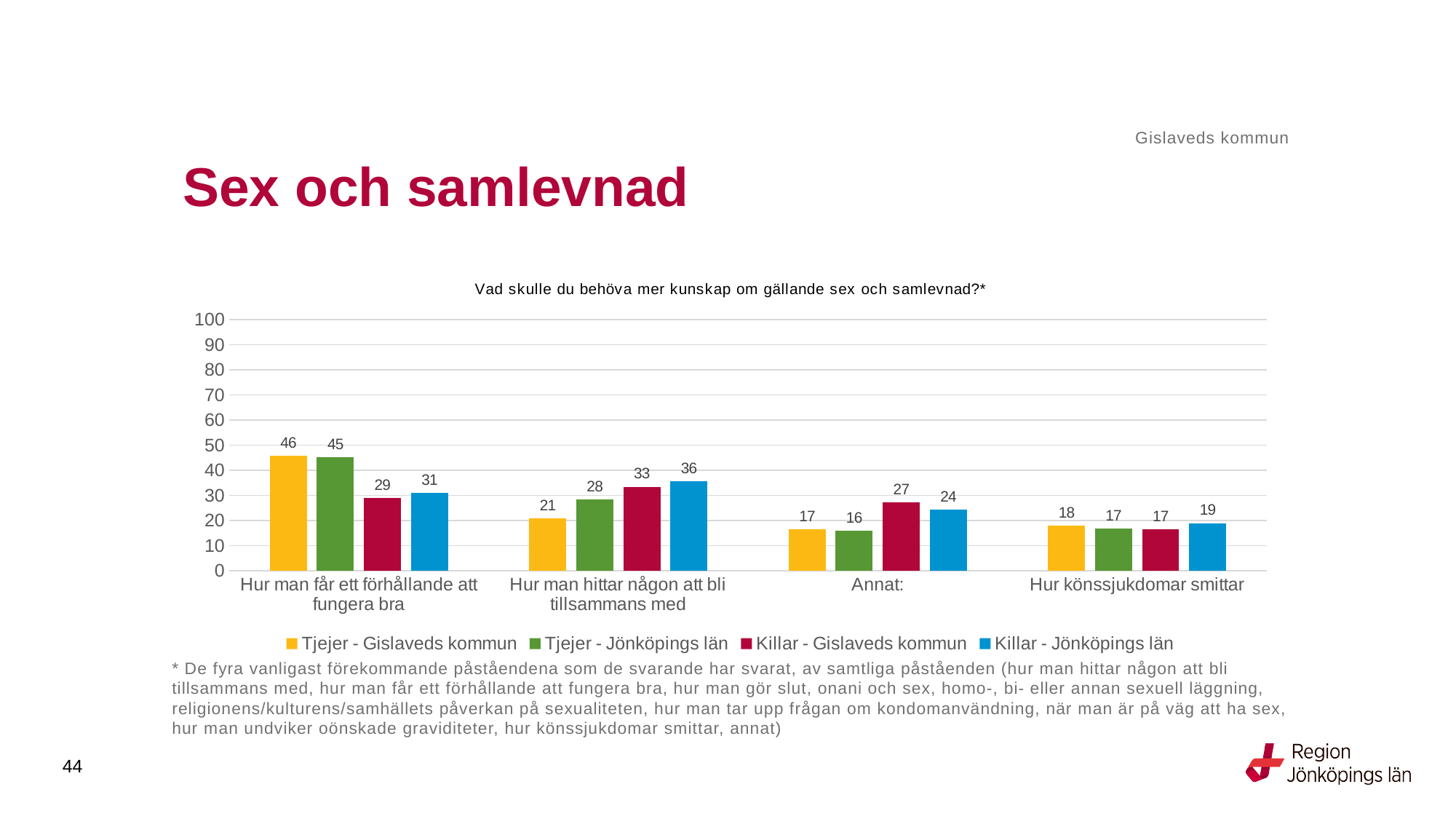
How many series does the legend list? 4 What is the difference between Tjejer - Gislaveds kommun and Killar - Gislaveds kommun for 'Hur man får ett förhållande att fungera bra'? 17 Which is larger for 'Hur man hittar någon att bli tillsammans med': Tjejer - Gislaveds kommun or Killar - Gislaveds kommun? Killar - Gislaveds kommun Which category has the lowest value for Tjejer - Jönköpings län? Annat: What is the value for Killar - Jönköpings län for 'Hur man hittar någon att bli tillsammans med'? 36 What is the value for Tjejer - Jönköpings län for 'Hur könssjukdomar smittar'? 17 What kind of chart is shown on the slide? Bar chart What is the title of the chart? Vad skulle du behöva mer kunskap om gällande sex och samlevnad?* What is the value for Tjejer - Gislaveds kommun for 'Hur man får ett förhållande att fungera bra'? 46 Which category has the highest value for Tjejer - Gislaveds kommun? Hur man får ett förhållande att fungera bra How many categories are shown on the x axis? 4 What is the value for Killar - Gislaveds kommun for 'Annat:'? 27